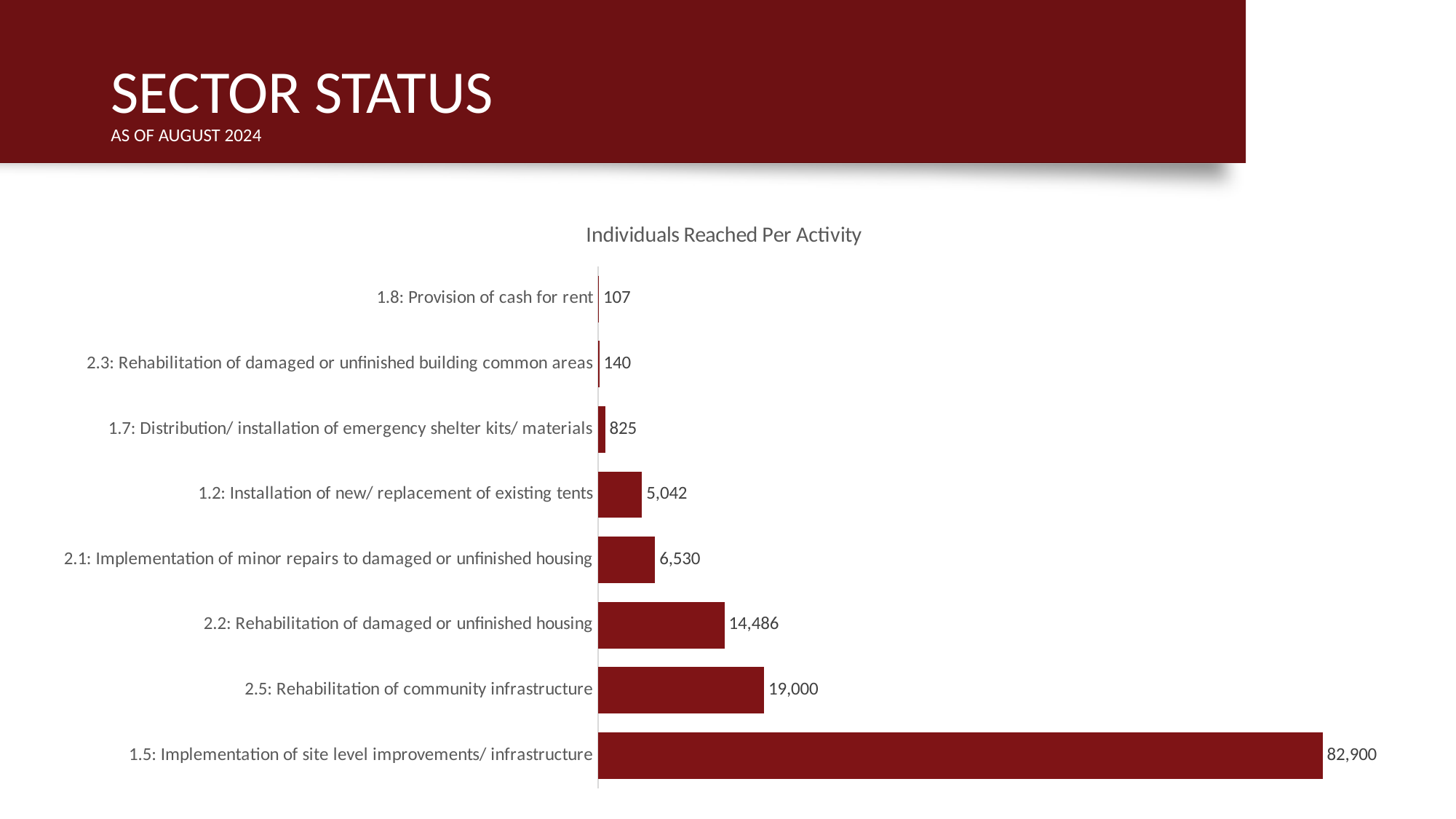
How many activities (categories) are shown in the chart? 8 How many individuals were reached by activity 1.2: Installation of new/ replacement of existing tents? 5,042 How many individuals were reached by activity 1.5: Implementation of site level improvements/ infrastructure? 82,900 What type of chart is shown on the slide? bar chart Which activity reached the fewest individuals? 1.8: Provision of cash for rent What is the difference in individuals reached between activity 2.3: Rehabilitation of damaged or unfinished building common areas and activity 1.8: Provision of cash for rent? 33 What is the difference in individuals reached between activity 2.5: Rehabilitation of community infrastructure and activity 2.2: Rehabilitation of damaged or unfinished housing? 4,514 How many individuals were reached by activity 2.5: Rehabilitation of community infrastructure? 19,000 What is the title of the chart? Individuals Reached Per Activity How many individuals were reached by activity 1.8: Provision of cash for rent? 107 Which reached more individuals: activity 2.1: Implementation of minor repairs to damaged or unfinished housing or activity 1.7: Distribution/ installation of emergency shelter kits/ materials? 2.1: Implementation of minor repairs to damaged or unfinished housing Which activity reached the most individuals? 1.5: Implementation of site level improvements/ infrastructure